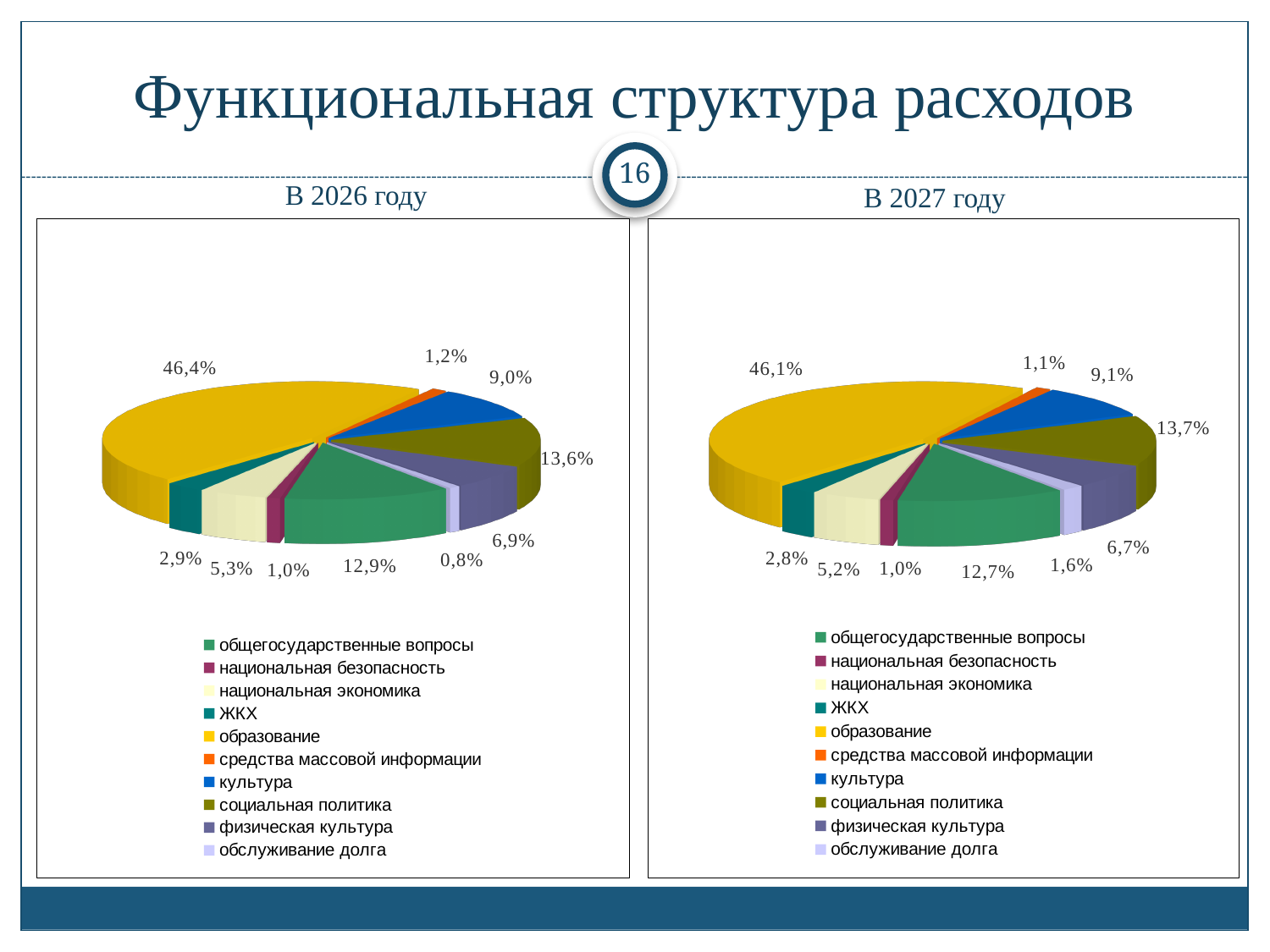
In the chart titled "В 2026 году", what share does ЖКХ have? 2,9% In the chart titled "В 2026 году", which category has the smallest slice? обслуживание долга In the chart titled "В 2027 году", what is the difference between the shares of образование and социальная политика? 32,4% In the chart titled "В 2027 году", what share does социальная политика have? 13,7% In the chart titled "В 2026 году", what share does образование have? 46,4% In the chart titled "В 2026 году", which category has the largest slice? образование What kind of chart is shown under "В 2026 году"? pie chart In the chart titled "В 2027 году", what is the difference between the shares of общегосударственные вопросы and культура? 3,6% How many pie charts are shown on the slide? 2 How many categories does the legend of the chart titled "В 2027 году" list? 10 In the chart titled "В 2027 году", what share does обслуживание долга have? 1,6% In the chart titled "В 2026 году", which is larger: the share of социальная политика or the share of общегосударственные вопросы? социальная политика